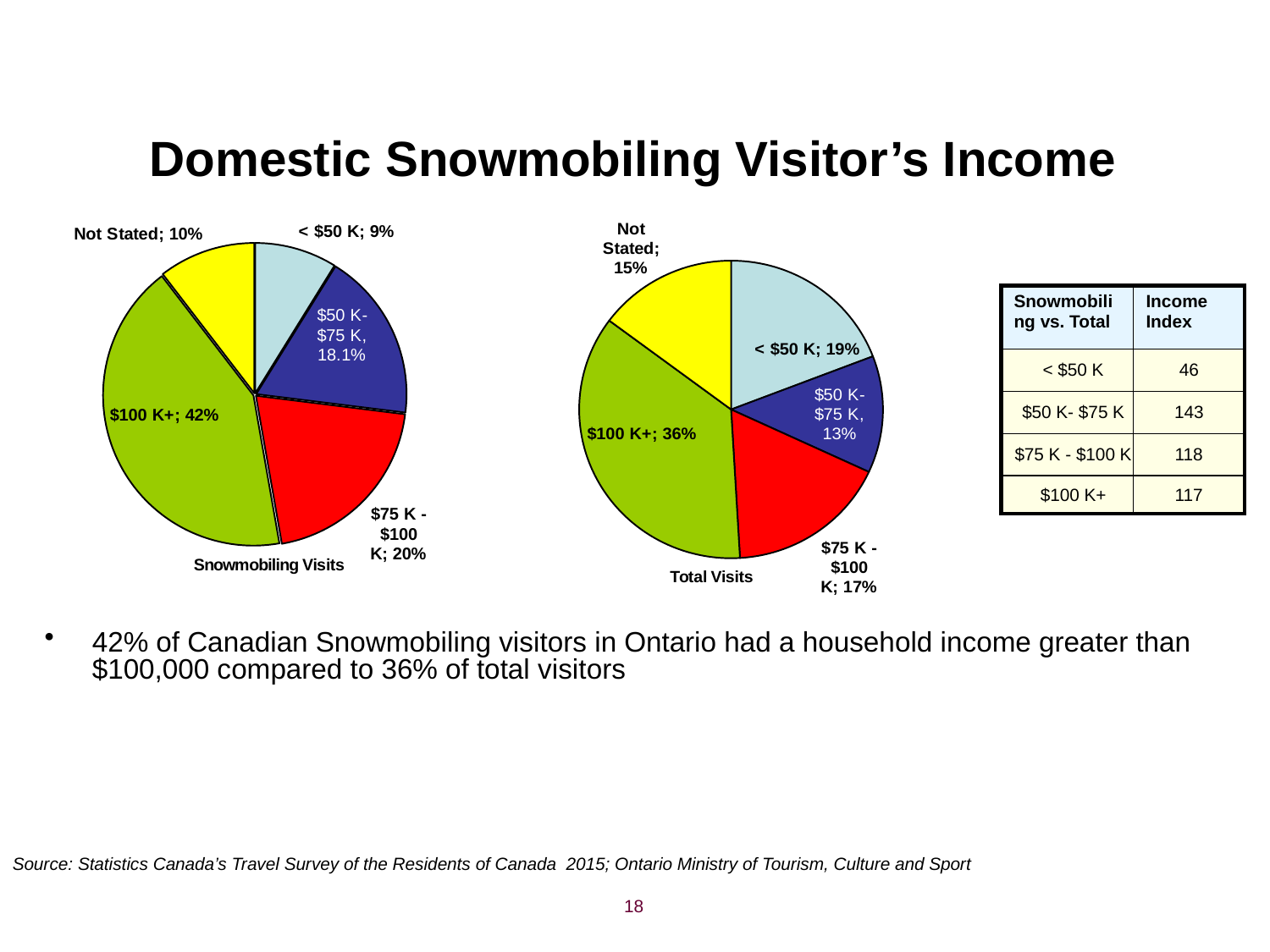
In the Snowmobiling Visits pie chart, which income category has the smallest slice? < $50 K In the Total Visits pie chart, what is the value for the Not Stated slice? 15% What type of chart is used to show the Total Visits data? Pie chart In the Total Visits pie chart, which income category has the smallest slice? $50 K-$75 K In the Snowmobiling Visits pie chart, what share of visitors had an income of $100 K+? 42% In the Snowmobiling Visits pie chart, what is the value for the $50 K-$75 K slice? 18.1% In the Snowmobiling Visits pie chart, which income category has the largest slice? $100 K+ In the Total Visits pie chart, what share of visitors had an income of < $50 K? 19% How many slices does the Snowmobiling Visits pie chart have? 5 In the Snowmobiling Visits pie chart, what colour is the $100 K+ slice? Green Which is larger: the < $50 K share in the Snowmobiling Visits chart or the < $50 K share in the Total Visits chart? Total Visits What is the difference between the $100 K+ share in the Snowmobiling Visits chart and the $100 K+ share in the Total Visits chart? 6 percentage points